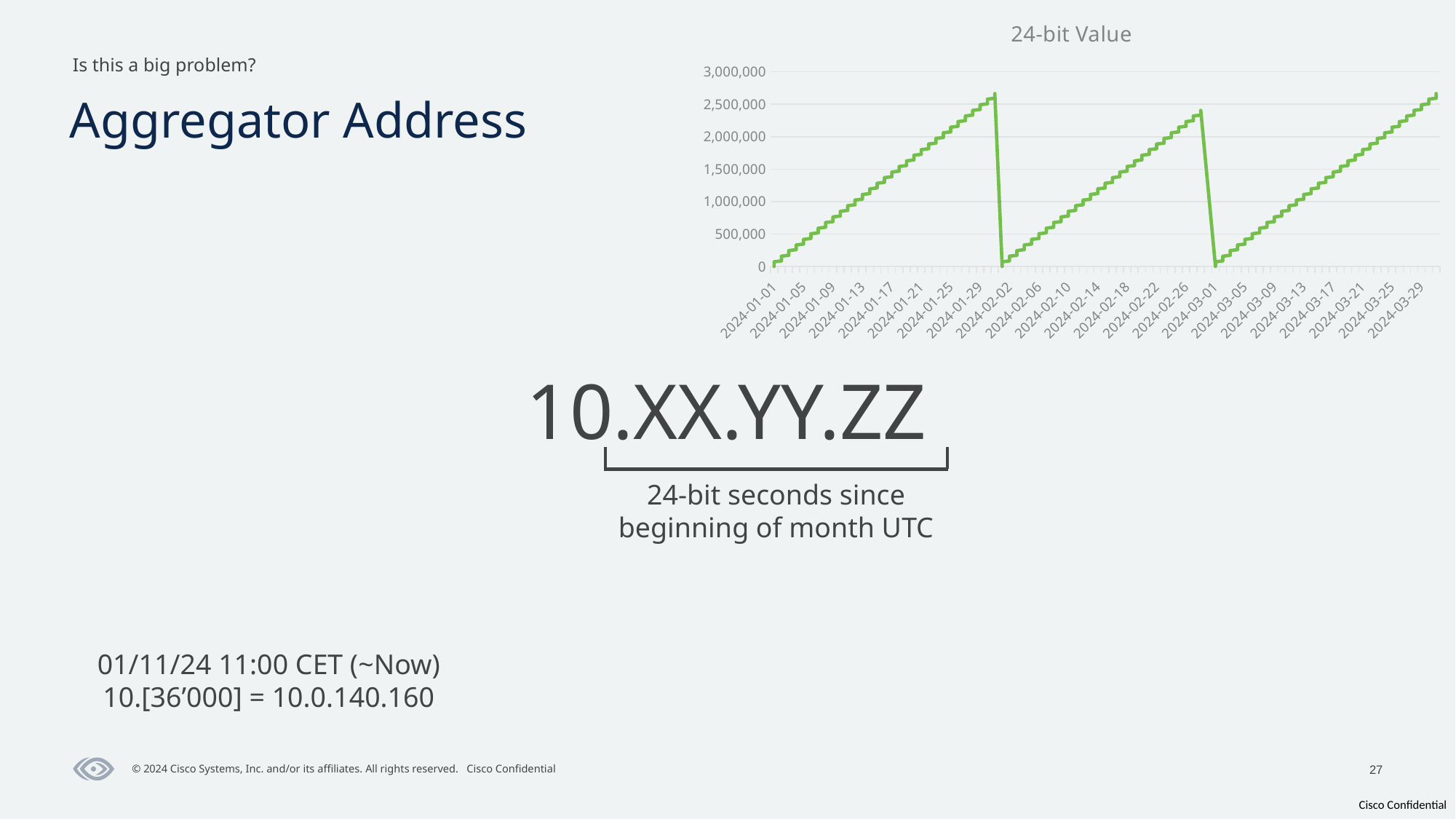
Which date has the larger value, 2024-01-29 or 2024-02-06? 2024-01-29 What is the highest value shown on the chart's y axis? 3,000,000 Is the value for 2024-03-29 greater or less than 2,000,000? greater Is the value for 2024-03-13 greater or less than 1,500,000? less How many lines (series) are plotted in the chart? 1 Does the value rise or fall between 2024-01-01 and 2024-01-29? rise Is the value for 2024-02-02 greater or less than 500,000? less What is the title of the chart? 24-bit Value What colour is the line plotted in the chart? green How many date labels are shown on the x axis? 23 What kind of chart is shown on the slide? line chart